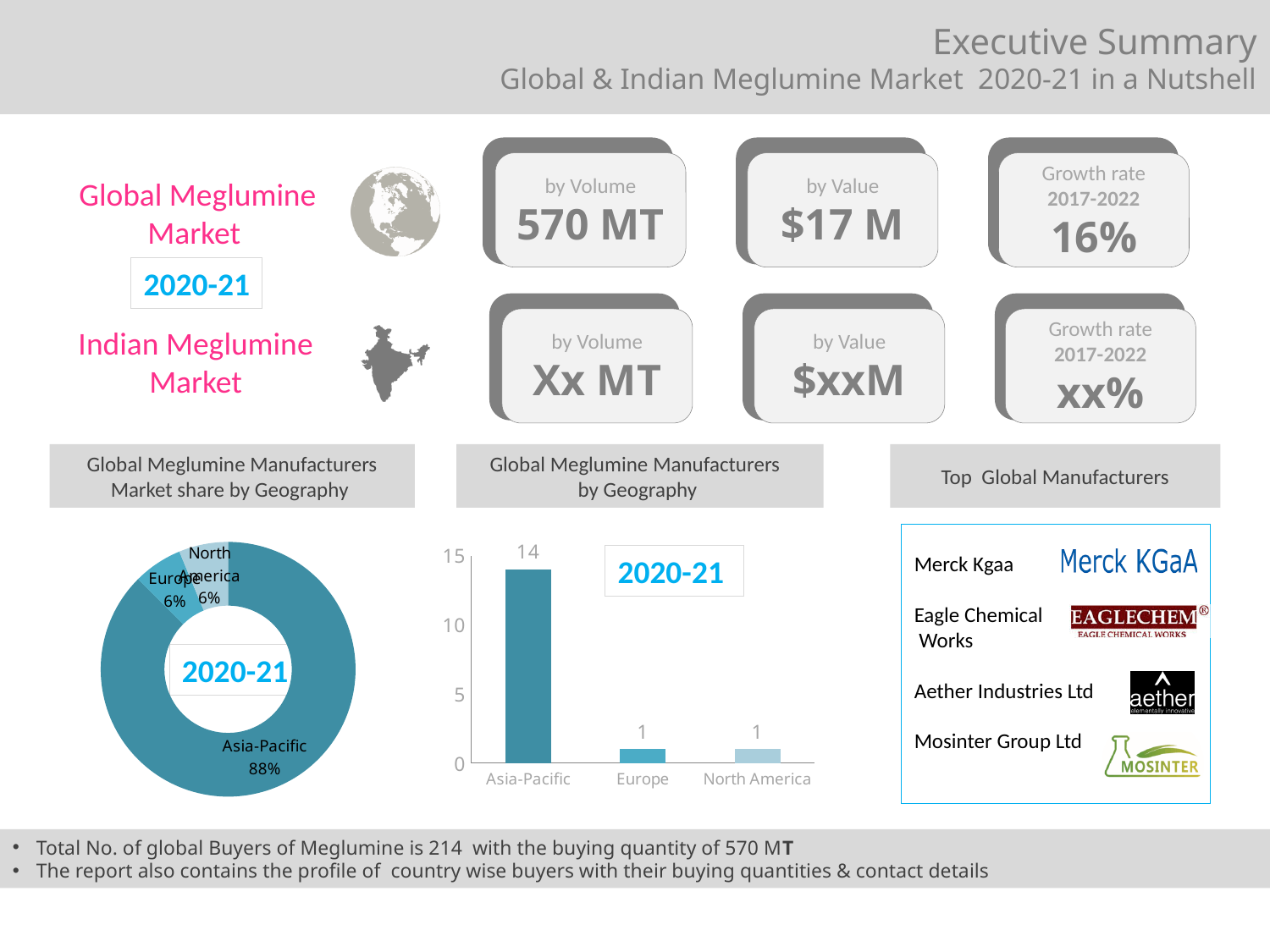
In the 'Global Meglumine Manufacturers by Geography' bar chart, what is the value for Asia-Pacific? 14 In the 'Global Meglumine Manufacturers Market share by Geography' chart, what share does Asia-Pacific have? 88% In the 'Global Meglumine Manufacturers by Geography' bar chart, what is the difference between the values for Asia-Pacific and North America? 13 In the 'Global Meglumine Manufacturers by Geography' bar chart, is the value for Asia-Pacific greater or less than 10? greater What kind of chart is 'Global Meglumine Manufacturers by Geography'? Bar chart In the 'Global Meglumine Manufacturers by Geography' bar chart, how many categories are shown on the x axis? 3 In the 'Global Meglumine Manufacturers by Geography' bar chart, which category has the highest value? Asia-Pacific In the 'Global Meglumine Manufacturers Market share by Geography' chart, what share does Europe have? 6% In the 'Global Meglumine Manufacturers Market share by Geography' chart, which region has the largest share? Asia-Pacific In the 'Global Meglumine Manufacturers by Geography' bar chart, what is the value for Europe? 1 What kind of chart is 'Global Meglumine Manufacturers Market share by Geography'? Doughnut chart What year label is shown in the centre of the 'Global Meglumine Manufacturers Market share by Geography' chart? 2020-21